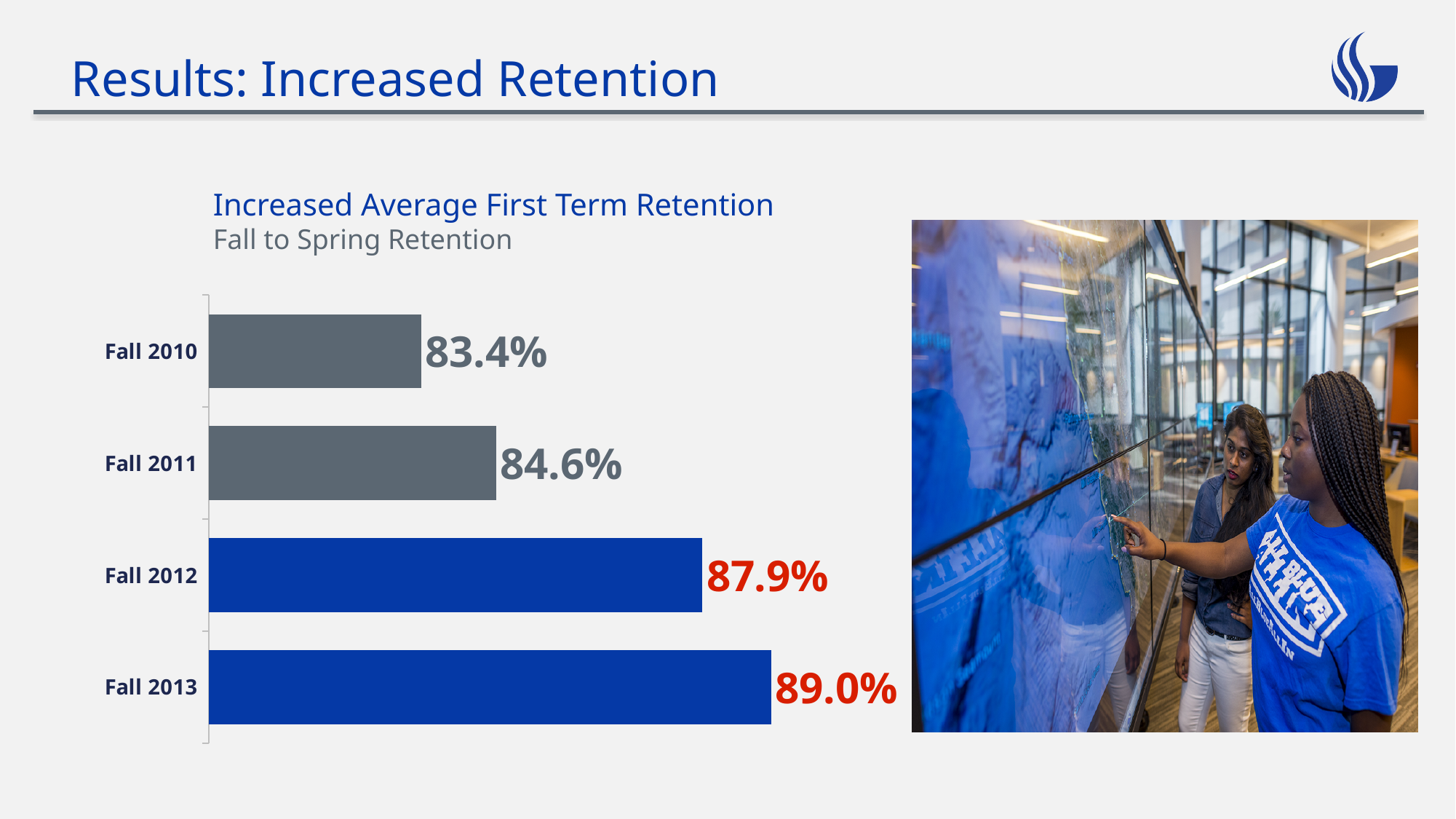
Which term has the highest retention value? Fall 2013 What is the Fall to Spring retention value for Fall 2013? 89.0% What is the difference in retention between Fall 2012 and Fall 2011? 3.3% Which has a higher retention value, Fall 2011 or Fall 2012? Fall 2012 What kind of chart is shown on the slide? Bar chart What is the Fall to Spring retention value for Fall 2012? 87.9% Which term has the lowest retention value? Fall 2010 What is the Fall to Spring retention value for Fall 2011? 84.6% What is the difference in retention between Fall 2013 and Fall 2010? 5.6% What is the Fall to Spring retention value for Fall 2010? 83.4% How many terms are shown in the chart? 4 Do the retention values rise or fall from Fall 2010 to Fall 2013? Rise